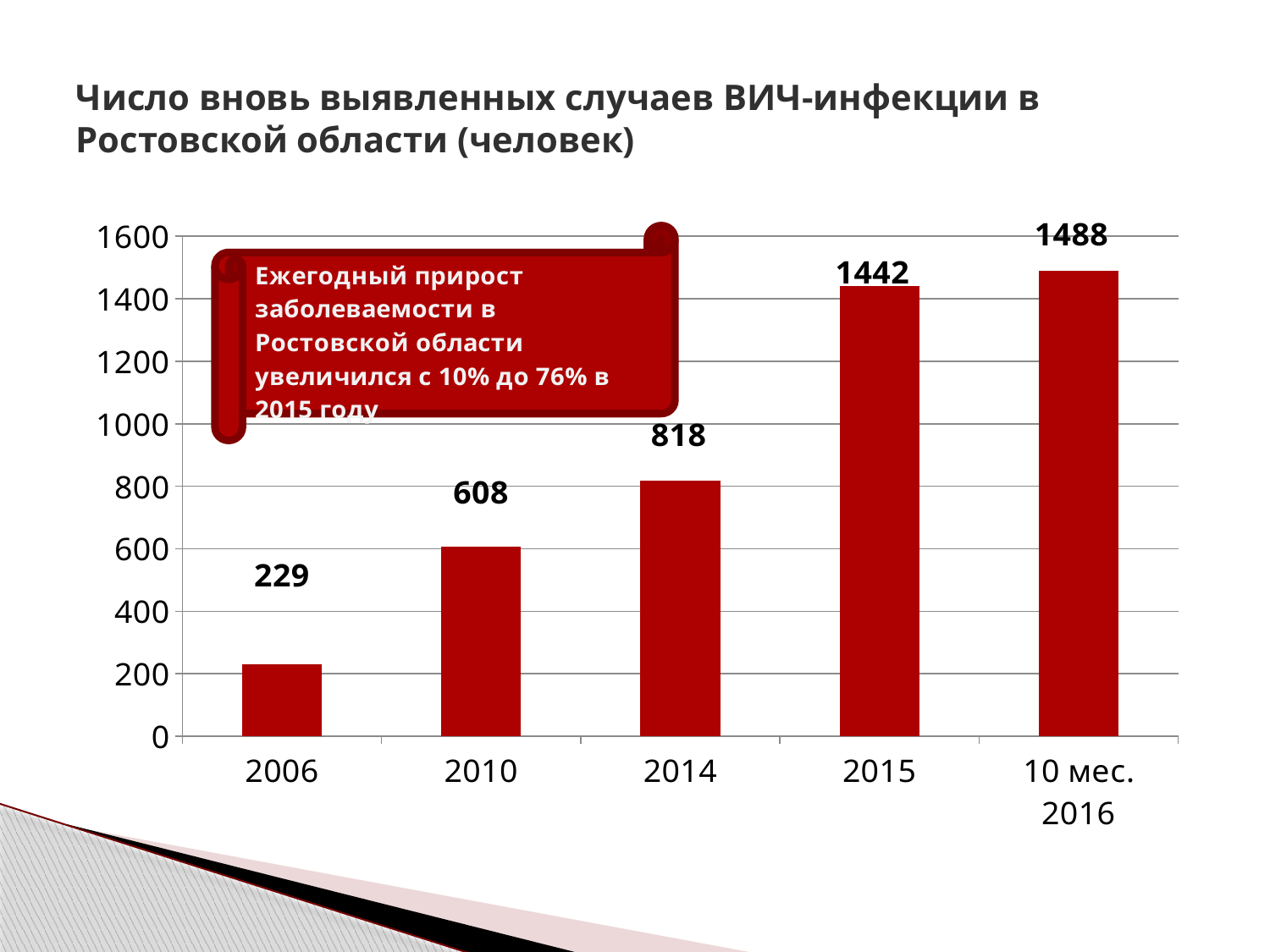
Which category has the highest value? 10 мес. 2016 What is the value for 2014? 818 Do the values rise or fall from 2006 to 10 мес. 2016? rise What is the value for 2006? 229 How many categories are shown on the x axis? 5 What is the difference between the values for 2010 and 2006? 379 What kind of chart is this? bar chart What is the value for 10 мес. 2016? 1488 Which is larger, the value for 2010 or the value for 2014? 2014 What is the value for 2015? 1442 Which category has the lowest value? 2006 What is the difference between the values for 2015 and 2014? 624